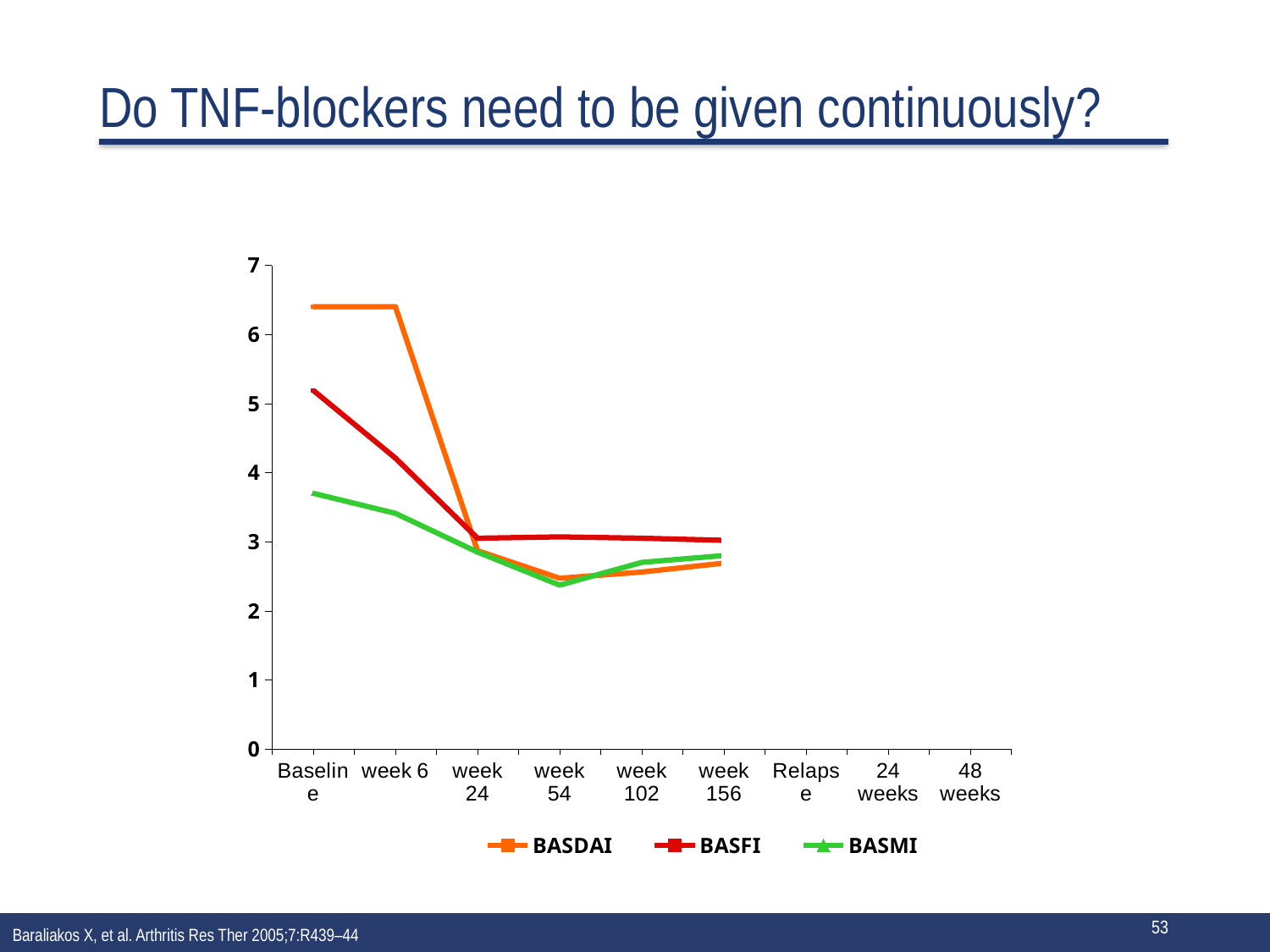
Which series has the lowest value at Baseline? BASMI Is the value for BASMI at Baseline greater or less than 4? less How many categories are labelled along the x axis? 9 Is the value for BASFI at Baseline greater or less than 4? greater Which series is drawn in green? BASMI At week 6, which is larger: BASFI or BASMI? BASFI What kind of chart is shown on the slide? line chart Is the value for BASDAI at week 54 greater or less than 3? less How many series does the legend list? 3 Does the BASDAI line rise or fall from Baseline to week 54? fall Which series has the highest value at Baseline? BASDAI